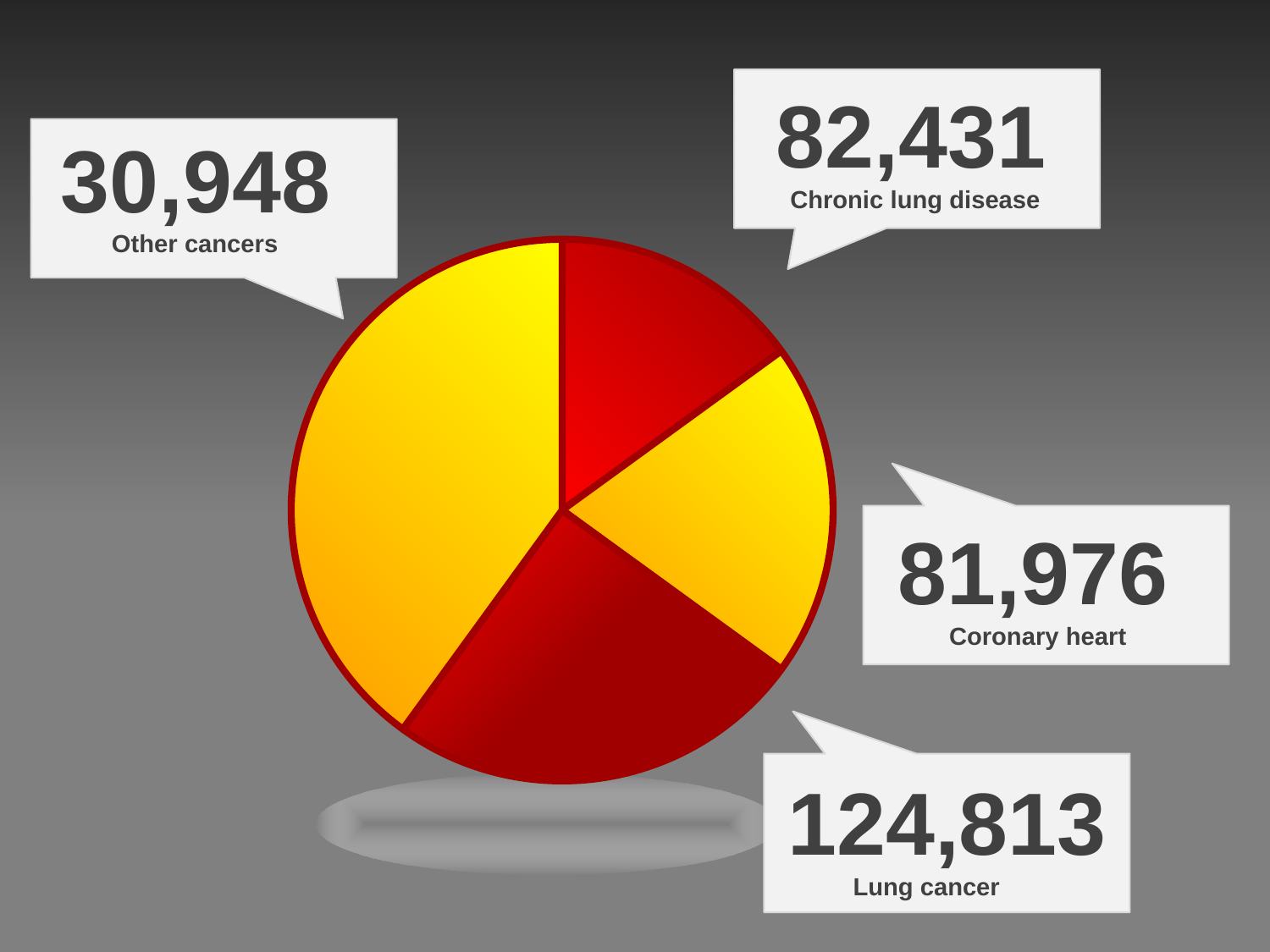
What is the difference between the values for Lung cancer and Other cancers? 93,865 What is the difference between the values for Chronic lung disease and Coronary heart? 455 What is the value shown for Lung cancer? 124,813 Which category has the highest value? Lung cancer What is the value shown for Coronary heart? 81,976 What is the value shown for Chronic lung disease? 82,431 What is the value shown for Other cancers? 30,948 Which category has the lowest value? Other cancers What kind of chart is shown on the slide? Pie chart How many categories are labelled on the pie chart? 4 Which is larger, the value for Chronic lung disease or the value for Coronary heart? Chronic lung disease What is the total of all four values shown on the pie chart? 320,168